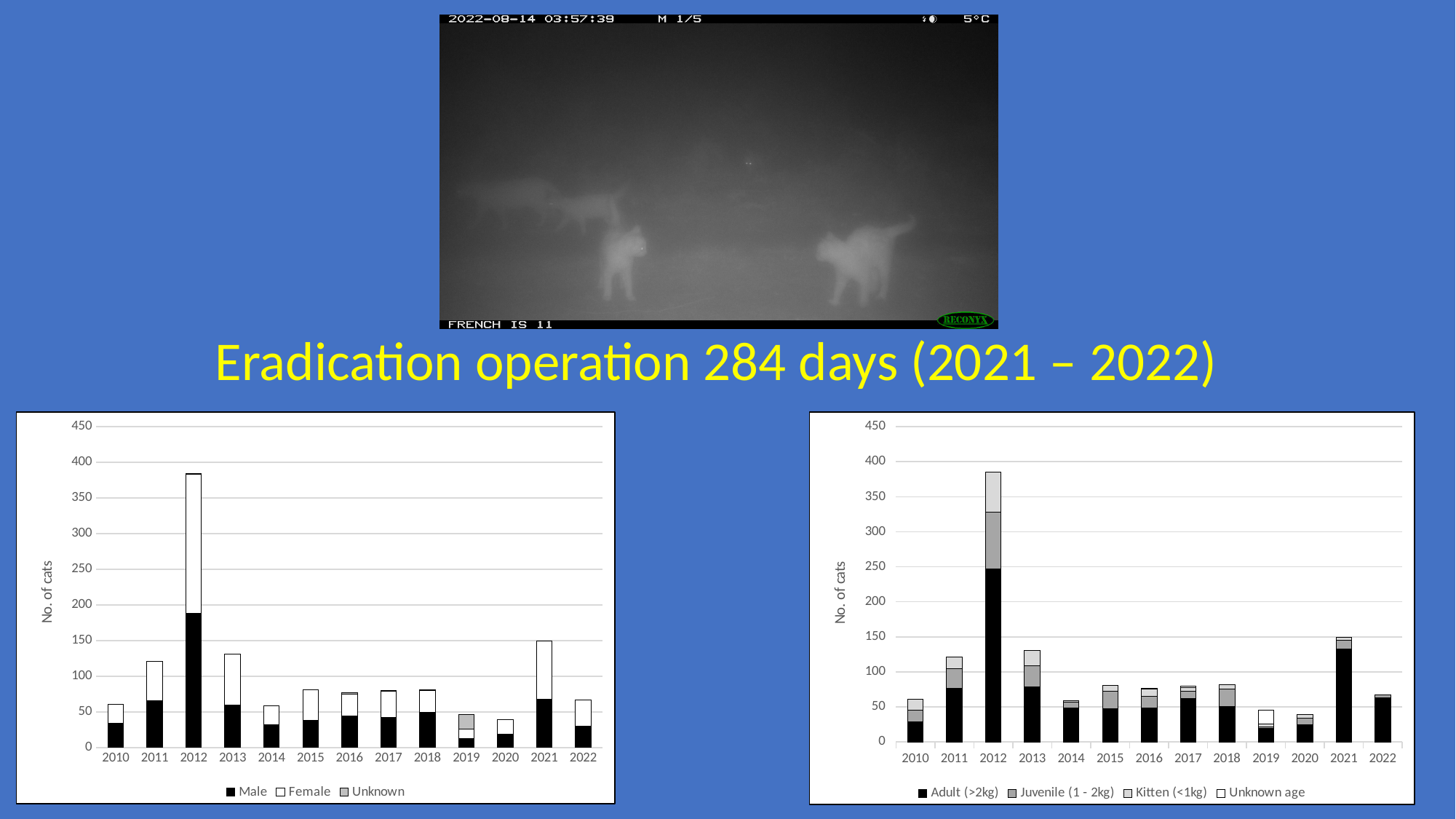
In the left chart, which bar is taller, 2010 or 2011? 2011 In the right chart, is the total bar for 2021 greater or less than 100? greater What is the y-axis label of the right chart? No. of cats In the left chart, is the total bar for 2012 greater or less than 350? greater What kind of chart is the left chart on the slide? Bar chart How many years are shown on the x axis of the left chart? 13 In the right chart, which bar is taller, 2012 or 2021? 2012 How many series does the legend of the right chart list? 4 In the right chart, which year has the tallest bar? 2012 In the left chart, which year has the tallest bar? 2012 In the left chart, is the total bar for 2010 greater or less than 100? less How many series does the legend of the left chart list? 3